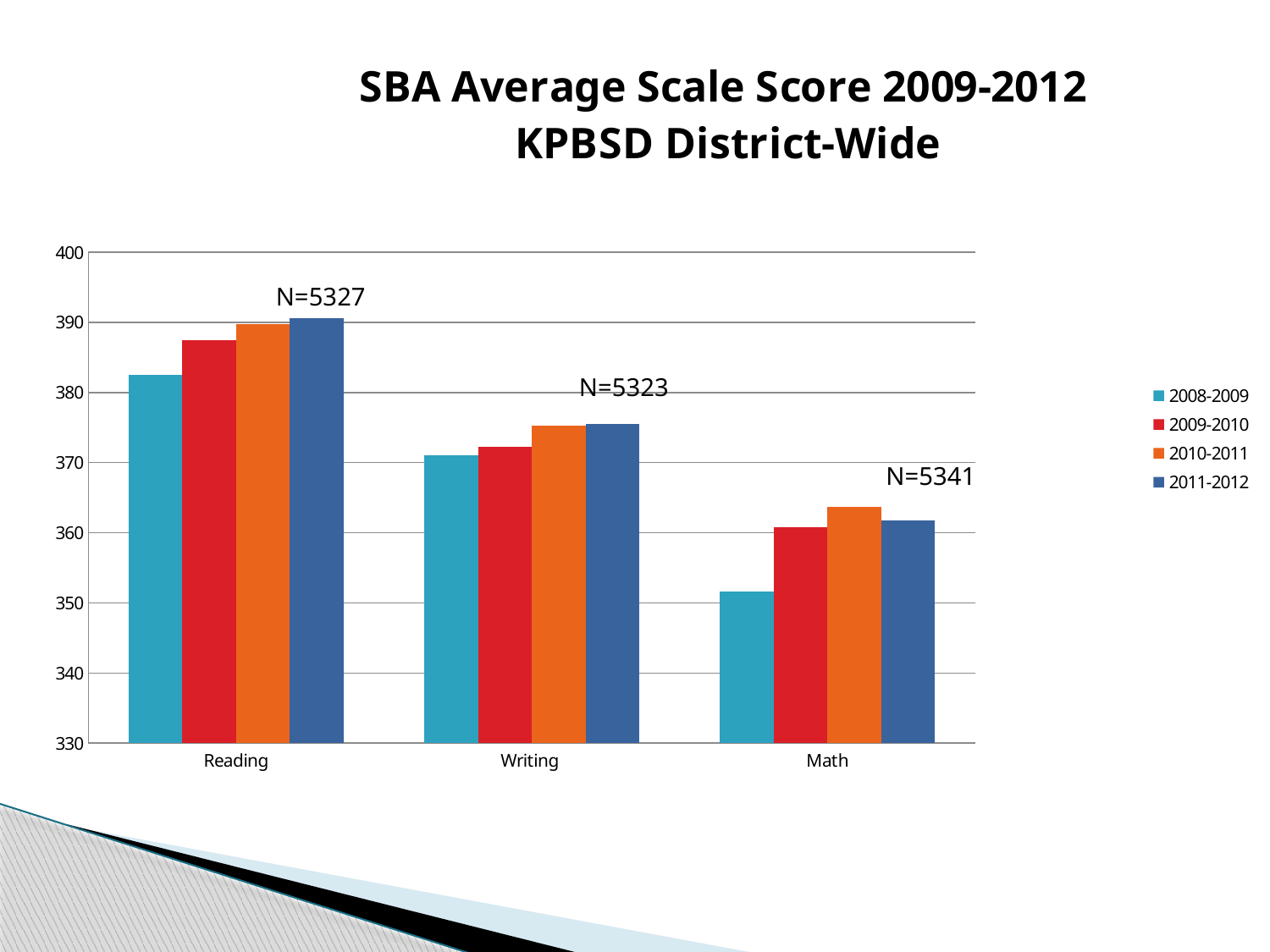
What is the title of the chart? SBA Average Scale Score 2009-2012 KPBSD District-Wide Is the 2009-2010 value for Reading greater or less than 390? less Is the 2010-2011 value for Writing greater or less than 370? greater Which subject has the highest average scale scores across all years? Reading What N value is printed above the Math bars? N=5341 Do the Reading scores rise or fall from 2008-2009 to 2011-2012? rise Which is larger, the 2008-2009 value for Reading or the 2008-2009 value for Writing? Reading Which subject has the lowest 2008-2009 bar? Math What kind of chart is shown on the slide? bar chart How many subject categories are shown on the x axis? 3 How many series does the legend list? 4 Is the 2008-2009 value for Math greater or less than 360? less